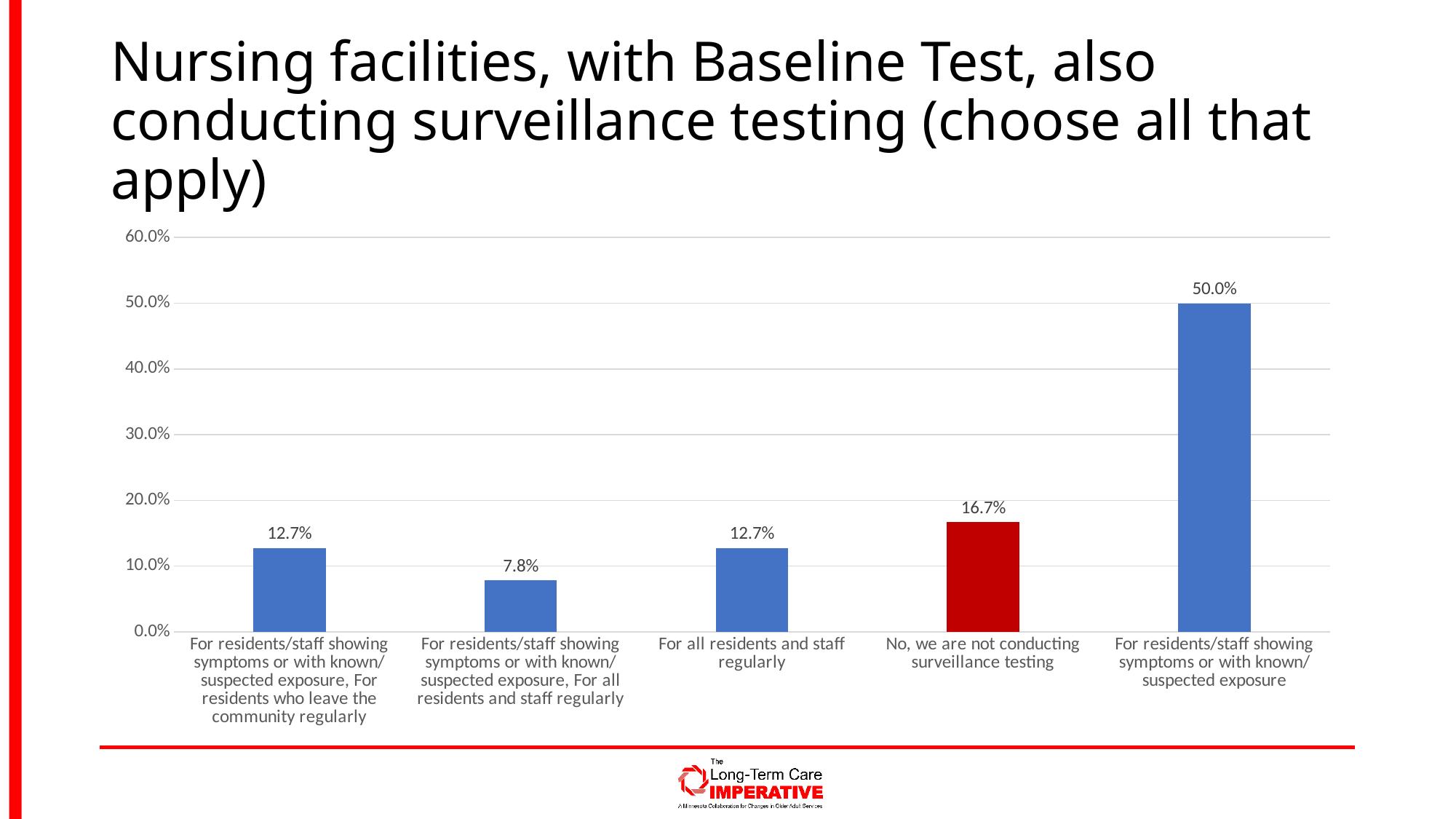
What is the value for "For residents/staff showing symptoms or with known/suspected exposure, For all residents and staff regularly"? 7.8% Which bar is coloured red rather than blue? No, we are not conducting surveillance testing Which category has the highest value? For residents/staff showing symptoms or with known/suspected exposure How many categories are shown on the chart? 5 What is the value for "For all residents and staff regularly"? 12.7% Which category has the lowest value? For residents/staff showing symptoms or with known/suspected exposure, For all residents and staff regularly What percentage of nursing facilities answered "No, we are not conducting surveillance testing"? 16.7% What is the value for "For residents/staff showing symptoms or with known/suspected exposure"? 50.0% Is the value for "For residents/staff showing symptoms or with known/suspected exposure" greater or less than 40.0%? greater Which is larger: the value for "No, we are not conducting surveillance testing" or the value for "For all residents and staff regularly"? No, we are not conducting surveillance testing What kind of chart is shown on the slide? bar chart What is the difference between the value for "For residents/staff showing symptoms or with known/suspected exposure" and the value for "No, we are not conducting surveillance testing"? 33.3%